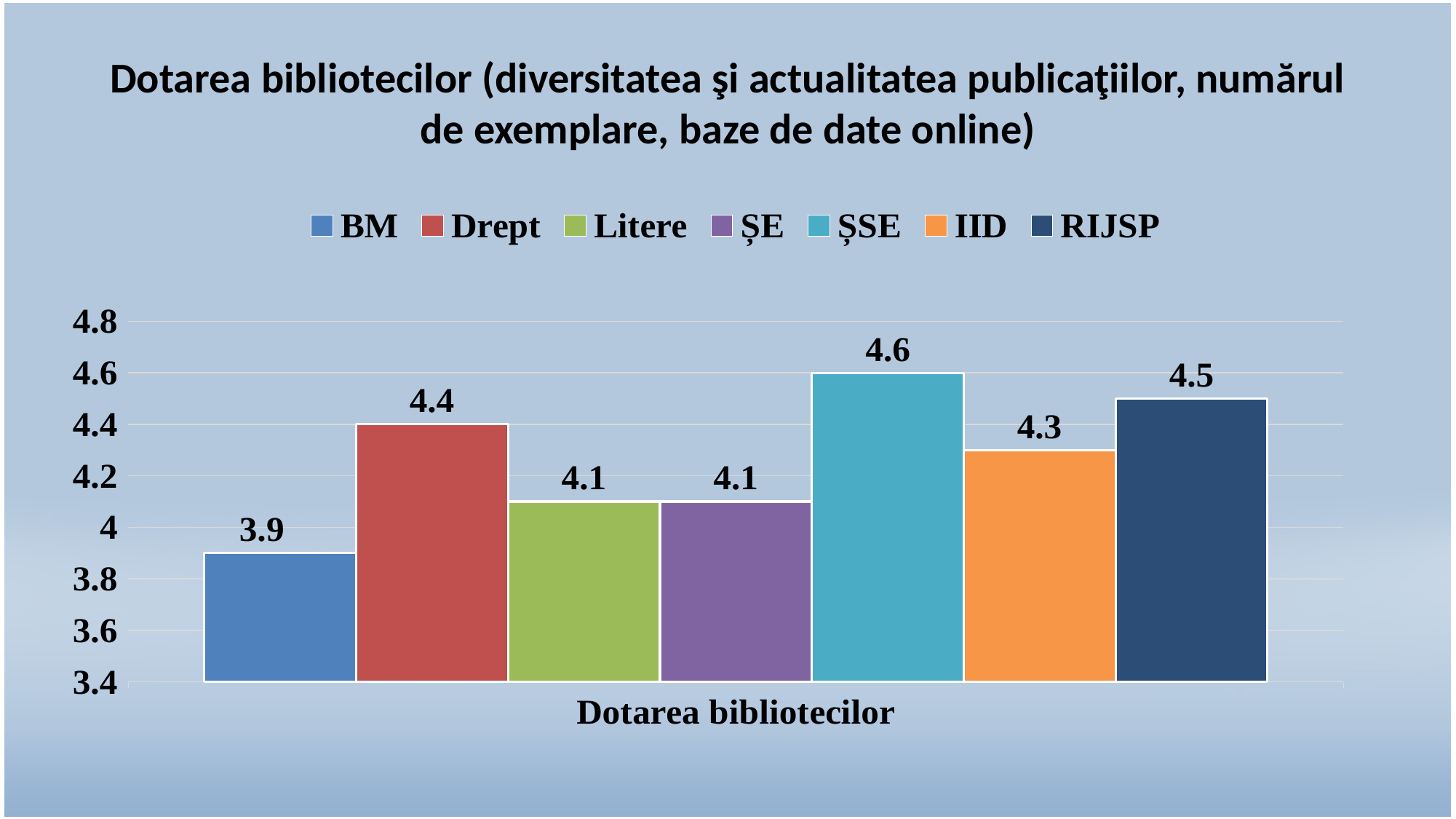
Which series has the highest value? ȘSE Which is larger, the value for RIJSP or the value for Drept? RIJSP What is the value for BM? 3.9 What is the difference between the values for ȘSE and BM? 0.7 What is the value for Drept? 4.4 What colour is the bar for ȘSE? teal How many series does the legend list? 7 What is the value for IID? 4.3 Which series has the lowest value? BM Is the value for Litere greater or less than 4.2? less What is the label on the x axis of the chart? Dotarea bibliotecilor What kind of chart is shown on the slide? bar chart